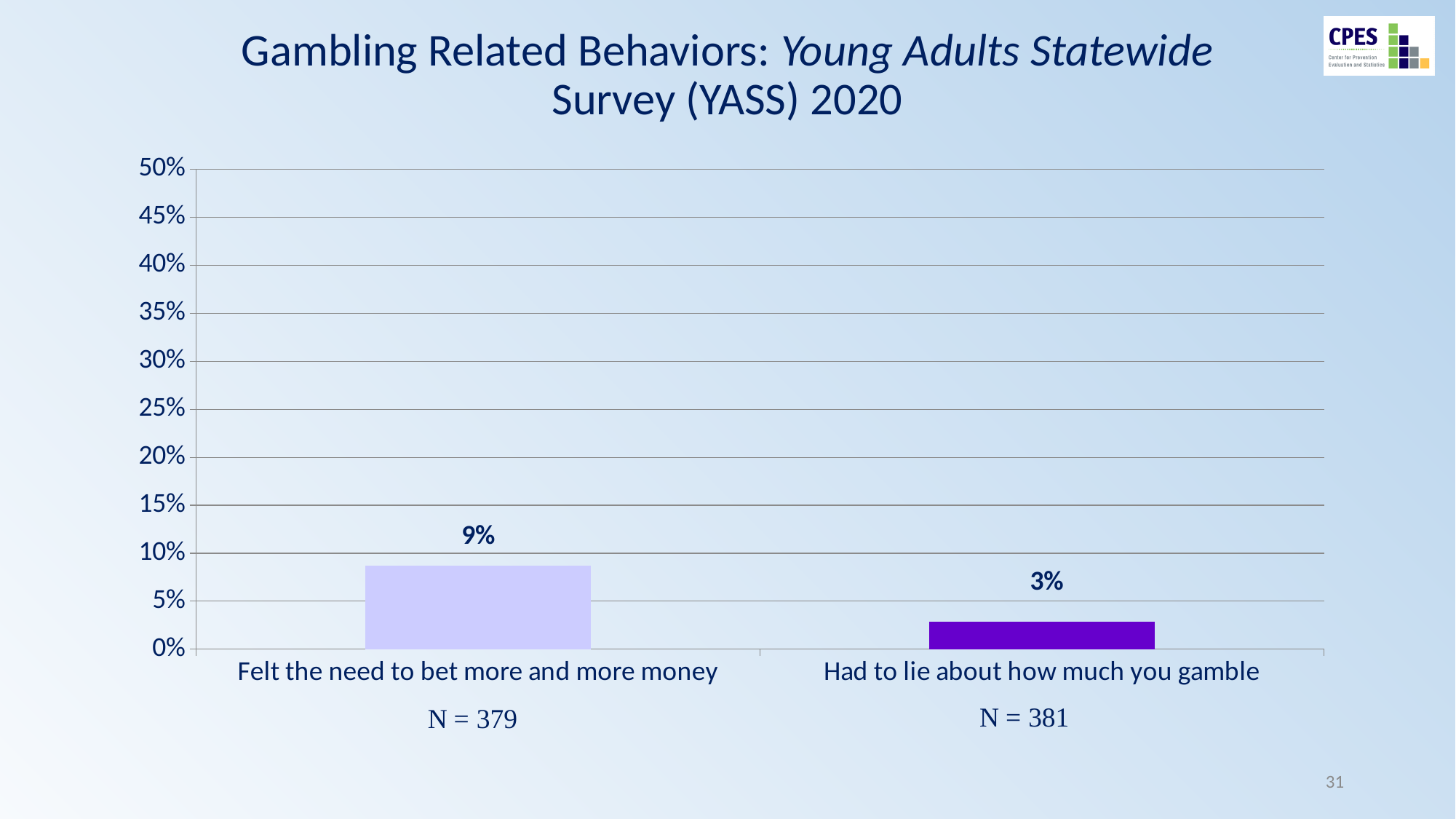
What is the maximum value shown on the y-axis? 50% Is the value for 'Felt the need to bet more and more money' greater or less than 10%? less What percentage of respondents felt the need to bet more and more money? 9% What kind of chart is shown on the slide? Bar chart What percentage of respondents had to lie about how much they gamble? 3% How many behavior categories are shown in the chart? 2 What is the sample size (N) for 'Had to lie about how much you gamble'? N = 381 Is the value for 'Had to lie about how much you gamble' greater or less than 5%? less Which behavior has the lower percentage? Had to lie about how much you gamble What is the difference in percentage points between 'Felt the need to bet more and more money' and 'Had to lie about how much you gamble'? 6% Which behavior has the higher percentage? Felt the need to bet more and more money